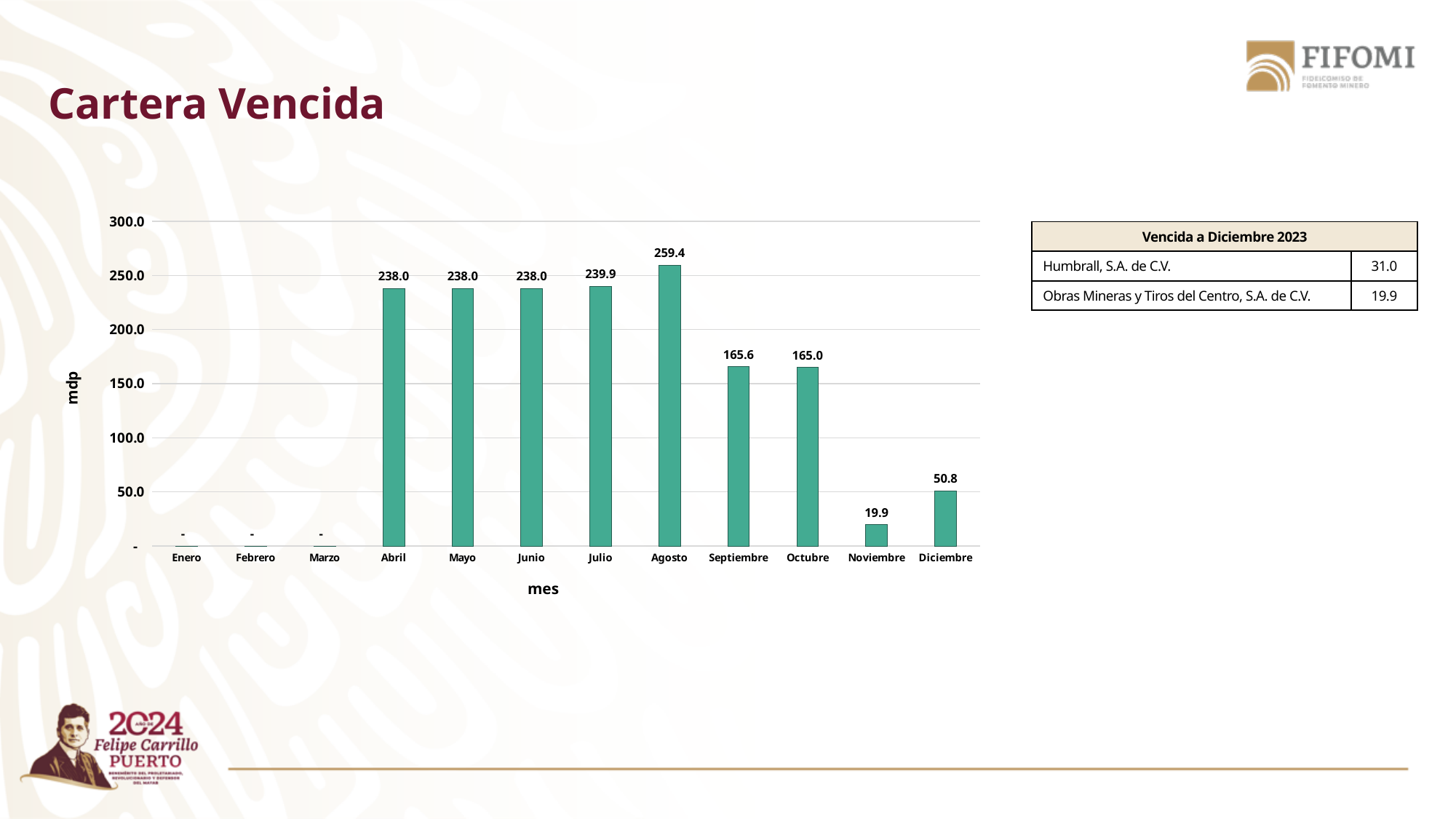
Which month has the highest value? Agosto Is the value for Septiembre greater or less than 150.0? greater What kind of chart is shown? bar chart How many months are shown on the x axis? 12 What is the value for Diciembre? 50.8 What is the value for Noviembre? 19.9 What is the label of the y axis? mdp What is the value for Agosto? 259.4 What is the difference between the values for Diciembre and Noviembre? 30.9 What is the difference between the values for Agosto and Septiembre? 93.8 Among the months with a non-zero bar, which has the lowest value? Noviembre Which is larger, the value for Julio or the value for Octubre? Julio